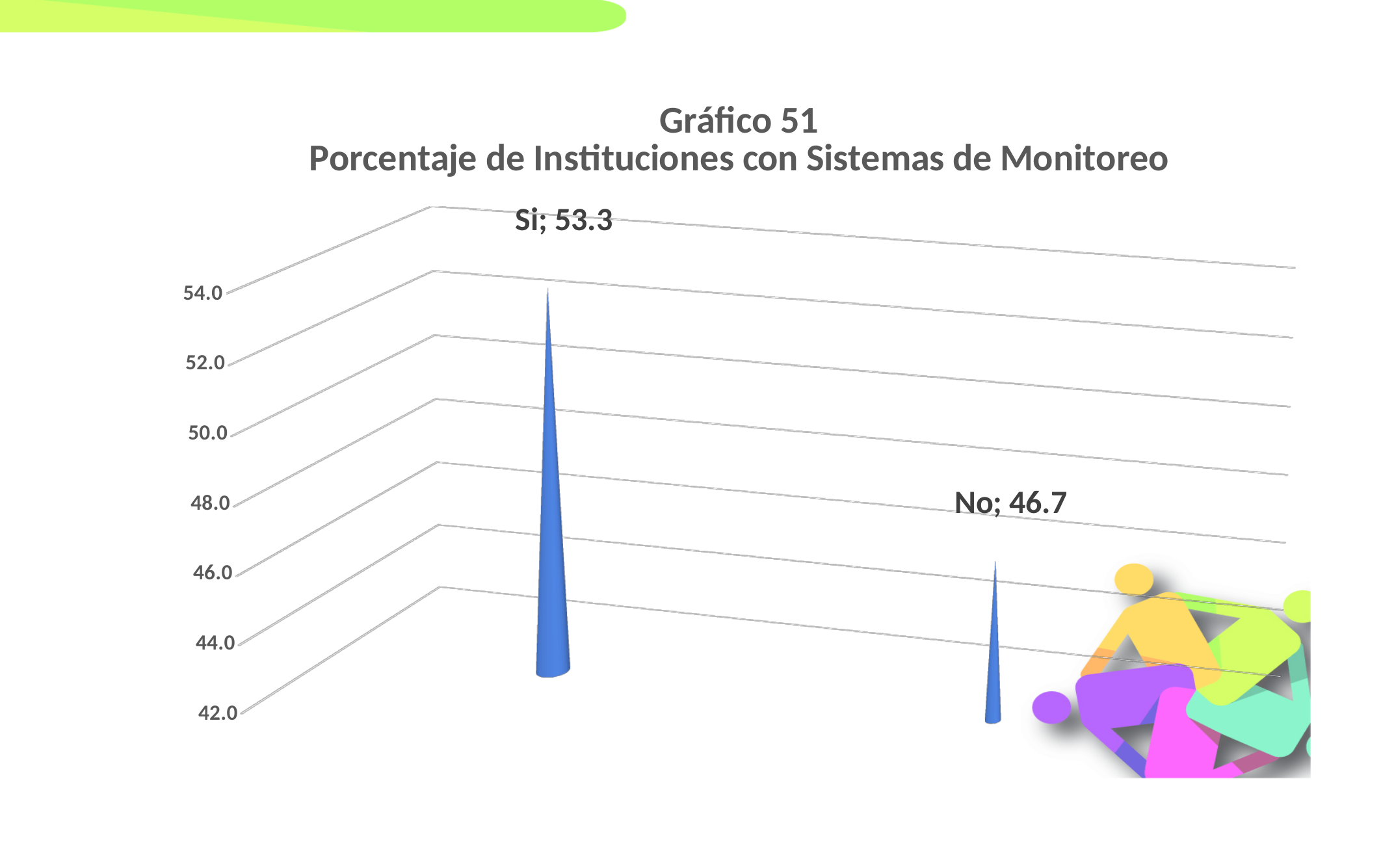
What is the difference between the values for Si and No? 6.6 What is the value for No? 46.7 Which category has the highest value? Si What is the value for Si? 53.3 How many categories are shown in the chart? 2 Is the value for No greater or less than 48.0? less Which category has the lowest value? No What kind of chart is shown on the slide? bar chart What is the title of the chart? Gráfico 51 Porcentaje de Instituciones con Sistemas de Monitoreo What is the highest value shown on the vertical axis? 54.0 Is the value for Si greater or less than 50.0? greater Which is larger, the value for Si or the value for No? Si